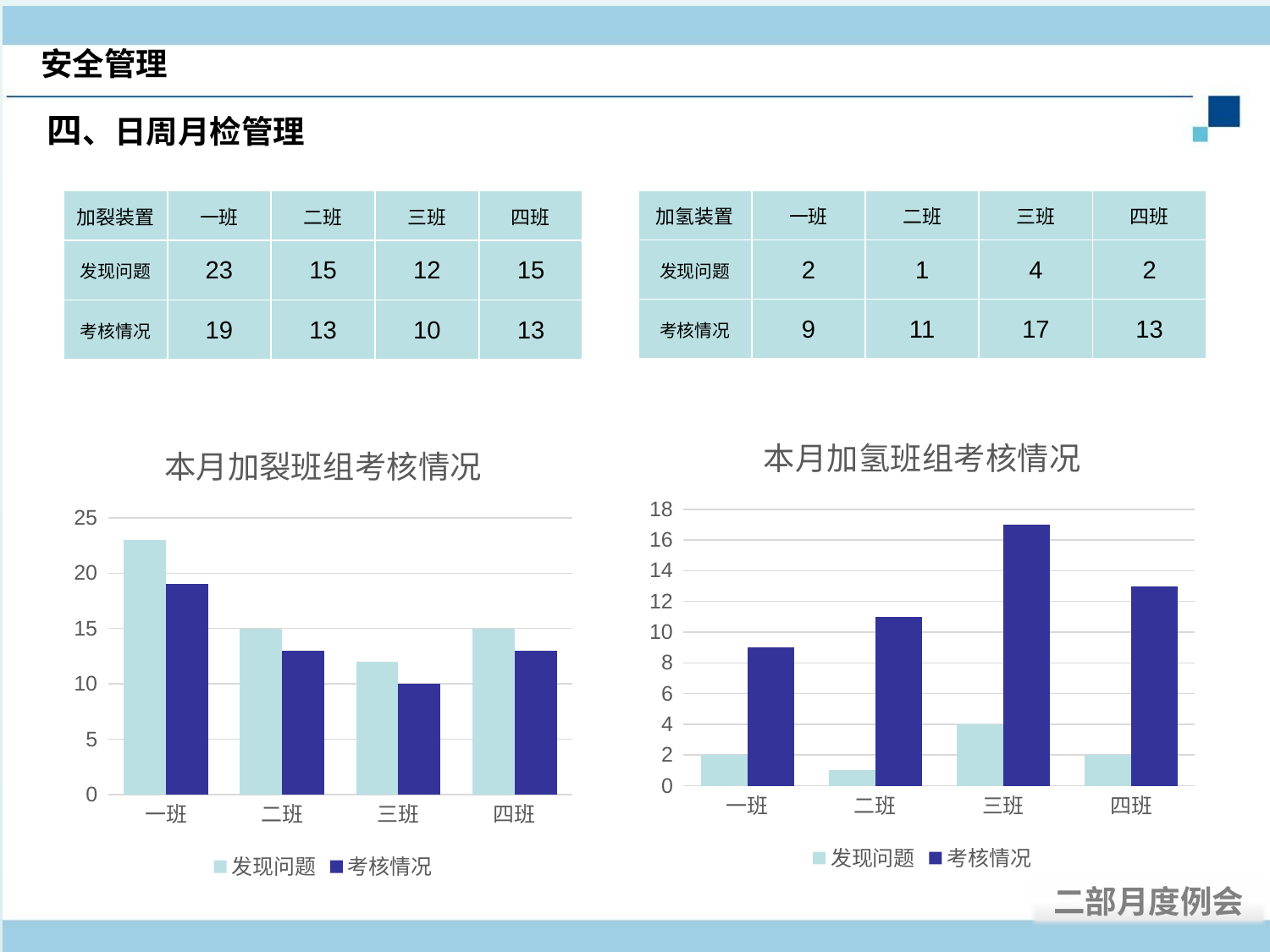
In the chart titled 本月加裂班组考核情况, which category has the highest 考核情况 value? 一班 In the chart titled 本月加氢班组考核情况, is the 考核情况 value for 二班 larger than the 考核情况 value for 四班? No In the chart titled 本月加裂班组考核情况, is the 发现问题 value for 一班 greater or less than 20? greater How many categories are shown on the x axis of the chart titled 本月加氢班组考核情况? 4 In the chart titled 本月加裂班组考核情况, what is the difference between 发现问题 and 考核情况 for 一班? 4 In the chart titled 本月加裂班组考核情况, which category has the lowest 发现问题 value? 三班 In the chart titled 本月加裂班组考核情况, what is the value of 发现问题 for 二班? 15 In the chart titled 本月加氢班组考核情况, which category has the lowest 考核情况 value? 一班 In the chart titled 本月加氢班组考核情况, what is the 考核情况 value for 三班? 17 How many series does the legend of the chart titled 本月加氢班组考核情况 list? 2 In the chart titled 本月加氢班组考核情况, is the 考核情况 value for 三班 greater or less than 16? greater What kind of chart is the chart titled 本月加裂班组考核情况? bar chart